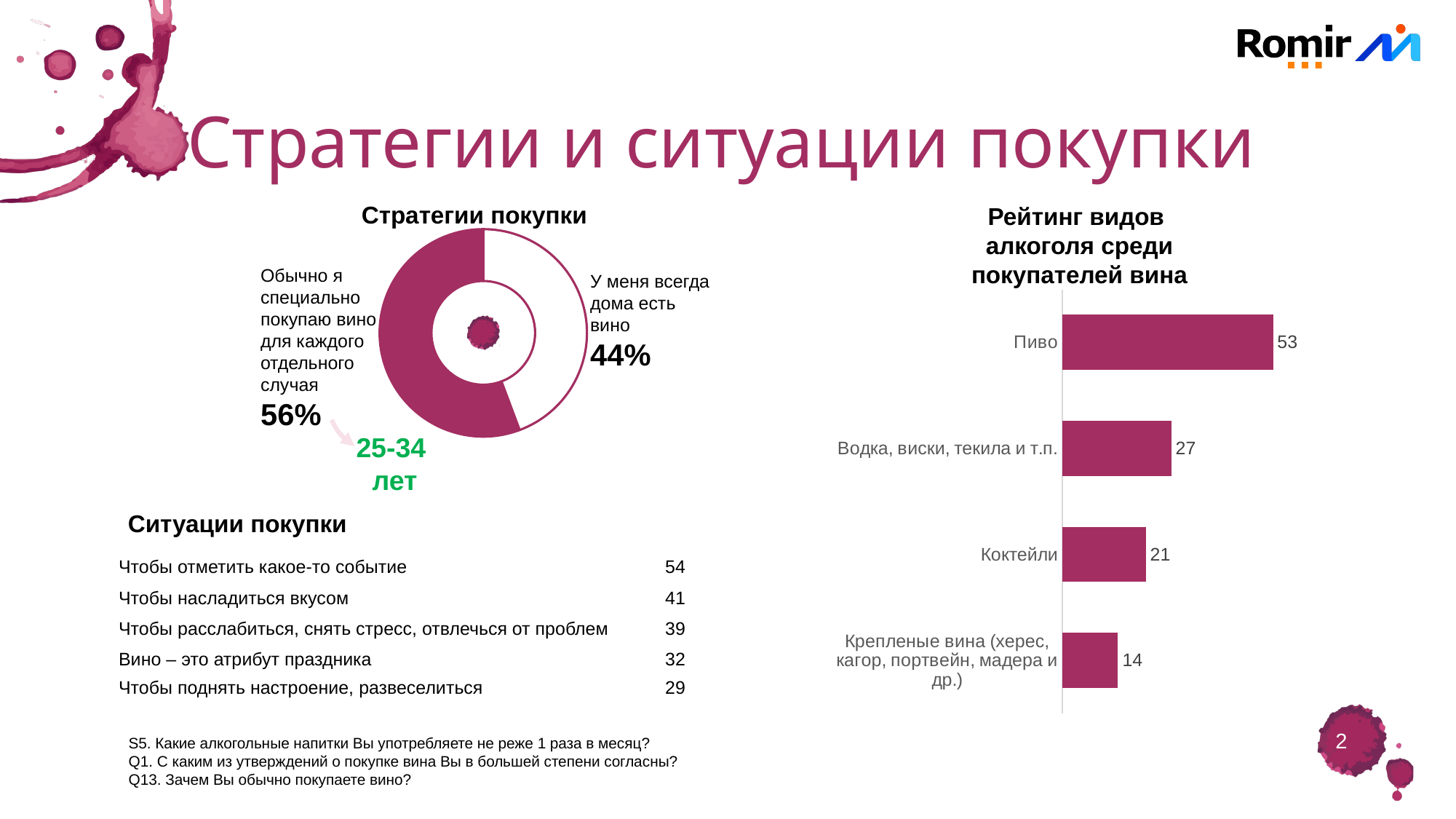
What type of chart is 'Стратегии покупки'? Donut chart In the 'Рейтинг видов алкоголя среди покупателей вина' chart, what is the value for Пиво? 53 In the 'Рейтинг видов алкоголя среди покупателей вина' chart, what is the difference between the values for Пиво and Водка, виски, текила и т.п.? 26 How many categories are shown in the 'Рейтинг видов алкоголя среди покупателей вина' chart? 4 In the 'Стратегии покупки' chart, what share is shown for 'Обычно я специально покупаю вино для каждого отдельного случая'? 56% In the 'Стратегии покупки' chart, what share is shown for 'У меня всегда дома есть вино'? 44% In the 'Рейтинг видов алкоголя среди покупателей вина' chart, which category has the highest value? Пиво In the 'Рейтинг видов алкоголя среди покупателей вина' chart, which category has the lowest value? Крепленые вина (херес, кагор, портвейн, мадера и др.) In the 'Рейтинг видов алкоголя среди покупателей вина' chart, what is the value for Коктейли? 21 In the 'Рейтинг видов алкоголя среди покупателей вина' chart, which is larger: Коктейли or Крепленые вина? Коктейли What type of chart is 'Рейтинг видов алкоголя среди покупателей вина'? Bar chart In the 'Рейтинг видов алкоголя среди покупателей вина' chart, what is the value for Водка, виски, текила и т.п.? 27